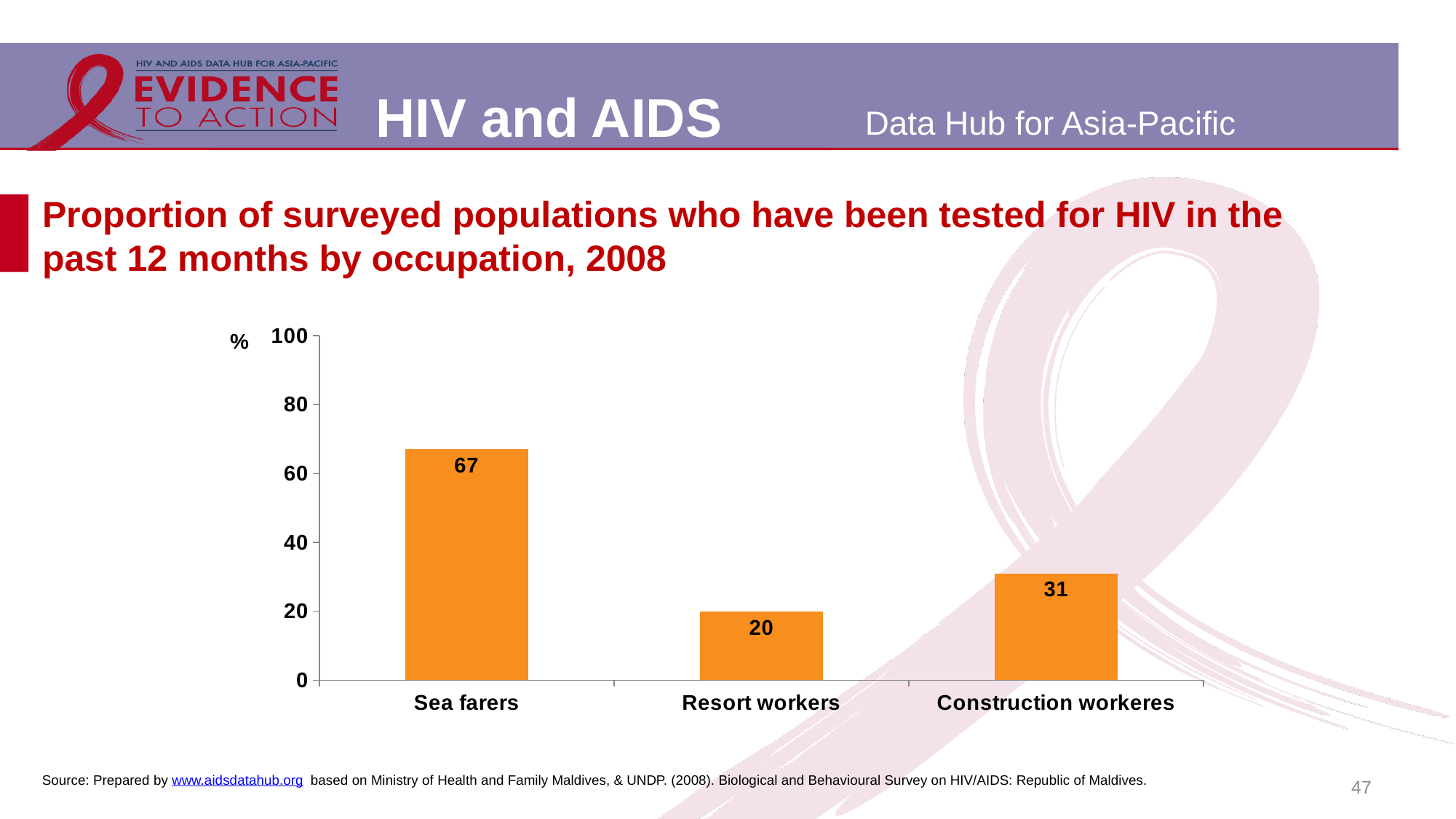
What is the difference between the values for Sea farers and Resort workers? 47 Is the value for Sea farers greater or less than 60? greater What kind of chart is shown on the slide? Bar chart What is the value for Construction workeres? 31 What is the value for Sea farers? 67 What is the difference between the values for Construction workeres and Resort workers? 11 Which occupation has the lowest proportion tested for HIV in the past 12 months? Resort workers What unit is shown on the y axis of the chart? % Which is larger, the value for Construction workeres or the value for Resort workers? Construction workeres How many occupation categories are shown in the chart? 3 Which occupation has the highest proportion tested for HIV in the past 12 months? Sea farers What is the value for Resort workers? 20